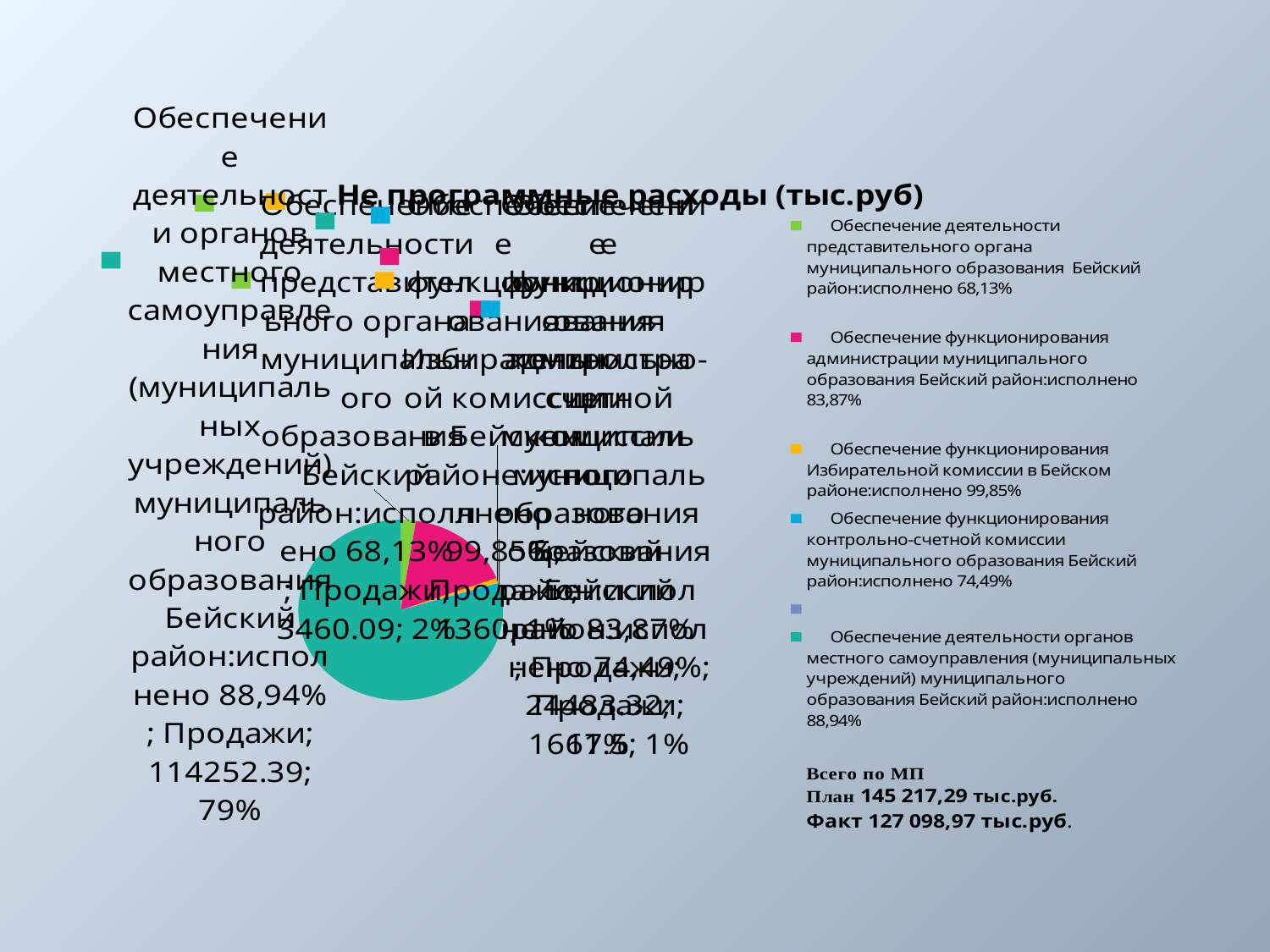
How many slices does the pie chart have? 5 What share of the pie does the slice for Обеспечение деятельности органов местного самоуправления (муниципальных учреждений) take? 79% What kind of chart is shown on the slide? pie chart What share of the pie does the slice for Обеспечение деятельности представительного органа муниципального образования Бейский район take? 2% What colour is the largest slice of the pie? teal (green-blue) Which slice is larger: Обеспечение функционирования администрации муниципального образования or Обеспечение деятельности представительного органа? Обеспечение функционирования администрации муниципального образования What is the title of the chart? Не программные расходы (тыс.руб) What is the difference in percentage share between the slice for органов местного самоуправления (79%) and the slice for представительного органа (2%)? 77% Which category has the largest slice of the pie? Обеспечение деятельности органов местного самоуправления (муниципальных учреждений) муниципального образования Бейский район What value is labelled on the slice for Обеспечение деятельности представительного органа муниципального образования Бейский район? 3460.09 What value is labelled on the slice for Обеспечение деятельности органов местного самоуправления (муниципальных учреждений)? 114252.39